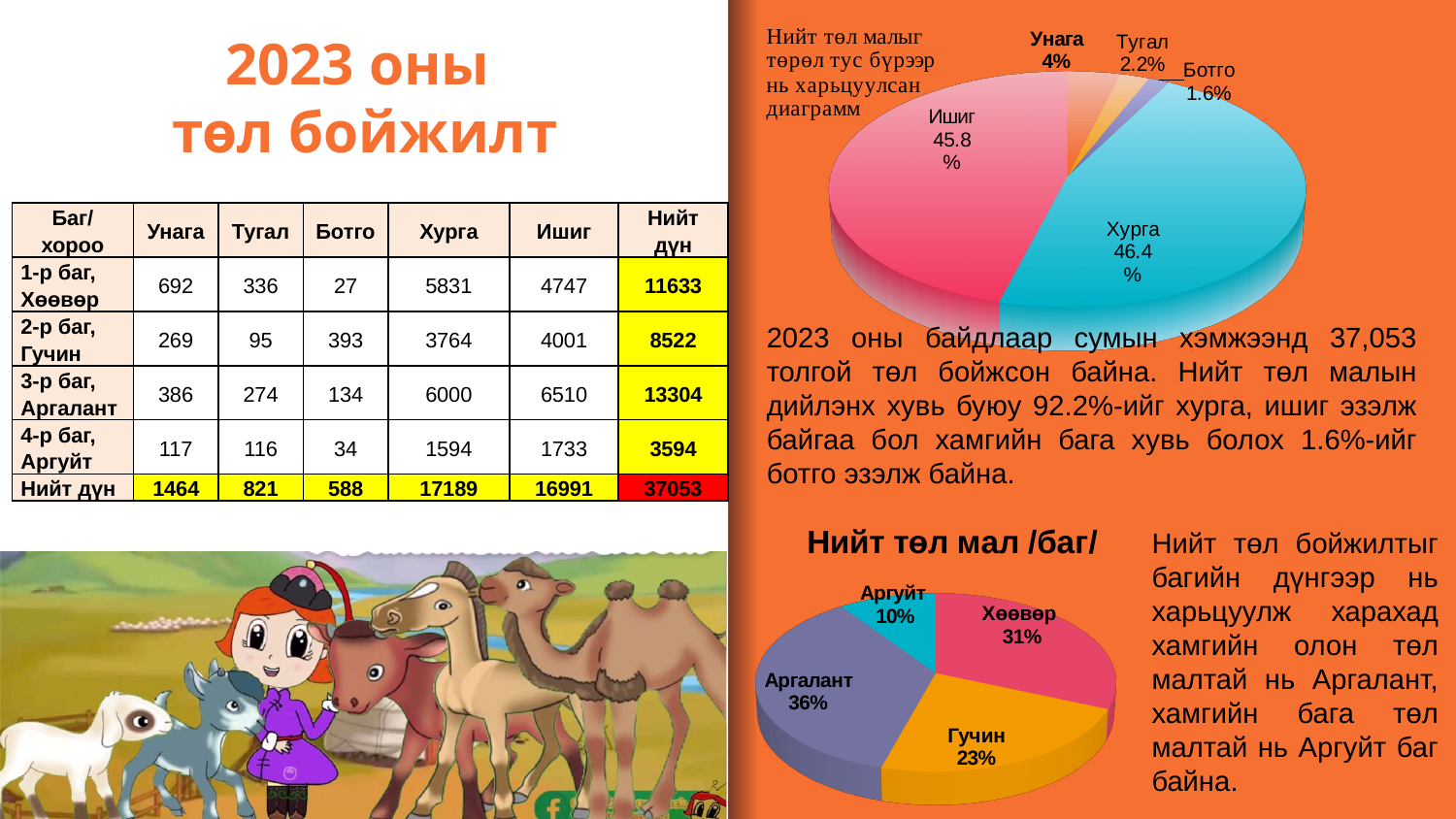
What type of chart is the chart titled 'Нийт төл мал /баг/'? Pie chart In the bottom pie chart titled 'Нийт төл мал /баг/', what share does Аргалант have? 36% In the top pie chart, which is larger, Унага or Тугал? Унага In the top pie chart, what share does Ишиг have? 45.8% In the top pie chart (Нийт төл малыг төрөл тус бүрээр нь харьцуулсан диаграмм), what share does Хурга have? 46.4% How many slices does the top pie chart have? 5 In the top pie chart, which category has the smallest share? Ботго In the bottom pie chart titled 'Нийт төл мал /баг/', which category has the smallest share? Аргуйт In the bottom pie chart titled 'Нийт төл мал /баг/', which category has the largest share? Аргалант In the top pie chart, what share does Ботго have? 1.6% In the top pie chart, what is the difference between the shares of Унага and Тугал? 1.8% In the bottom pie chart titled 'Нийт төл мал /баг/', what is the difference between the shares of Хөөвөр and Гучин? 8%